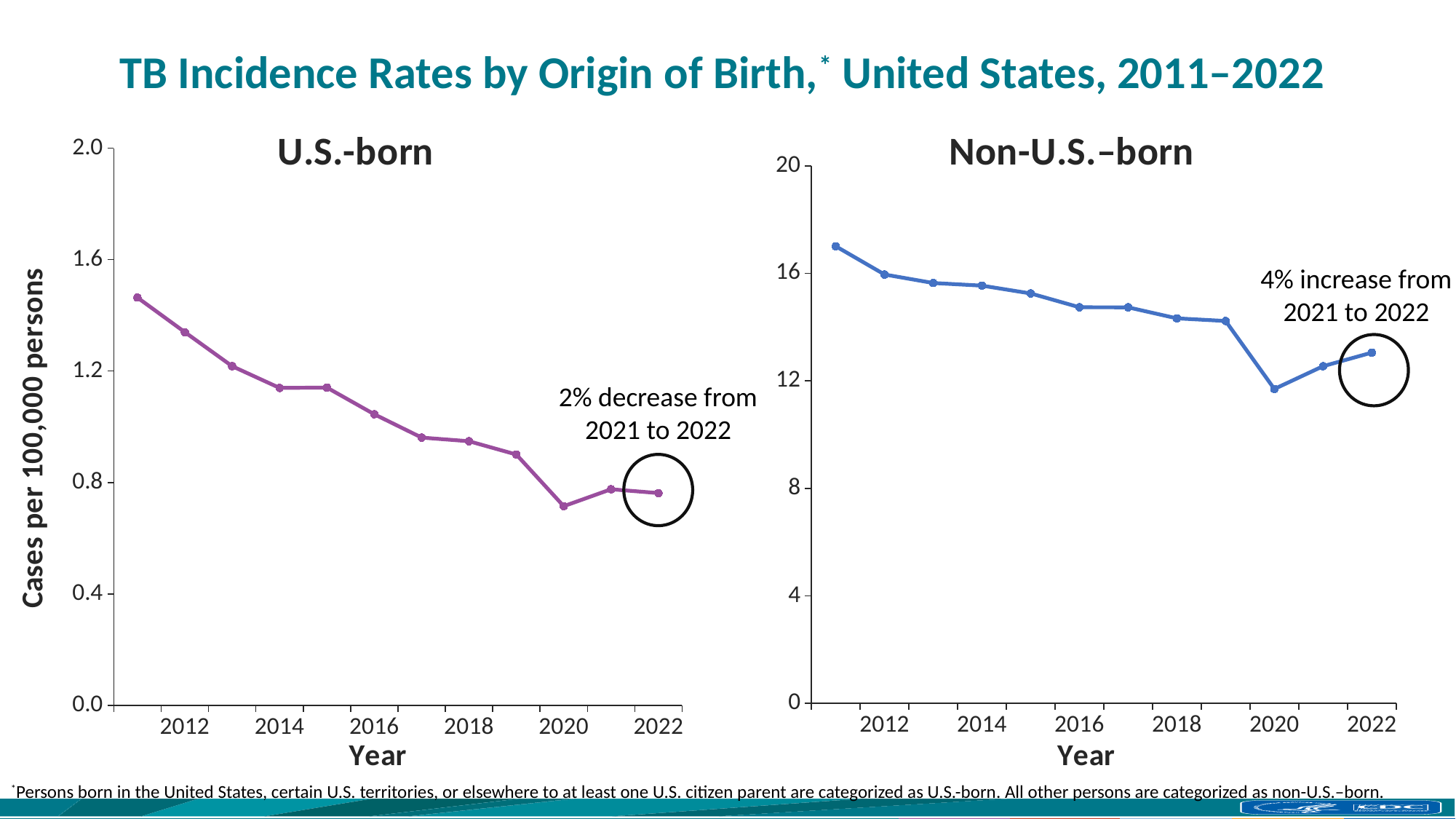
In the U.S.-born chart, is the value for 2020 greater or less than 0.8? less In the U.S.-born chart, what percentage change from 2021 to 2022 is annotated? 2% decrease In the U.S.-born chart, which year has the highest incidence rate? 2011 In the Non-U.S.-born chart, which year has the highest incidence rate? 2011 In the Non-U.S.-born chart, is the value for 2020 greater or less than 12? less In the U.S.-born chart, which year has the lowest incidence rate? 2020 In the Non-U.S.-born chart, which year has the lowest incidence rate? 2020 In the U.S.-born chart, is the value for 2011 greater or less than 1.2? greater In the Non-U.S.-born chart, do the values generally rise or fall from 2011 to 2020? Fall In the U.S.-born chart, how many years are plotted? 12 What kind of chart is the U.S.-born chart? Line chart